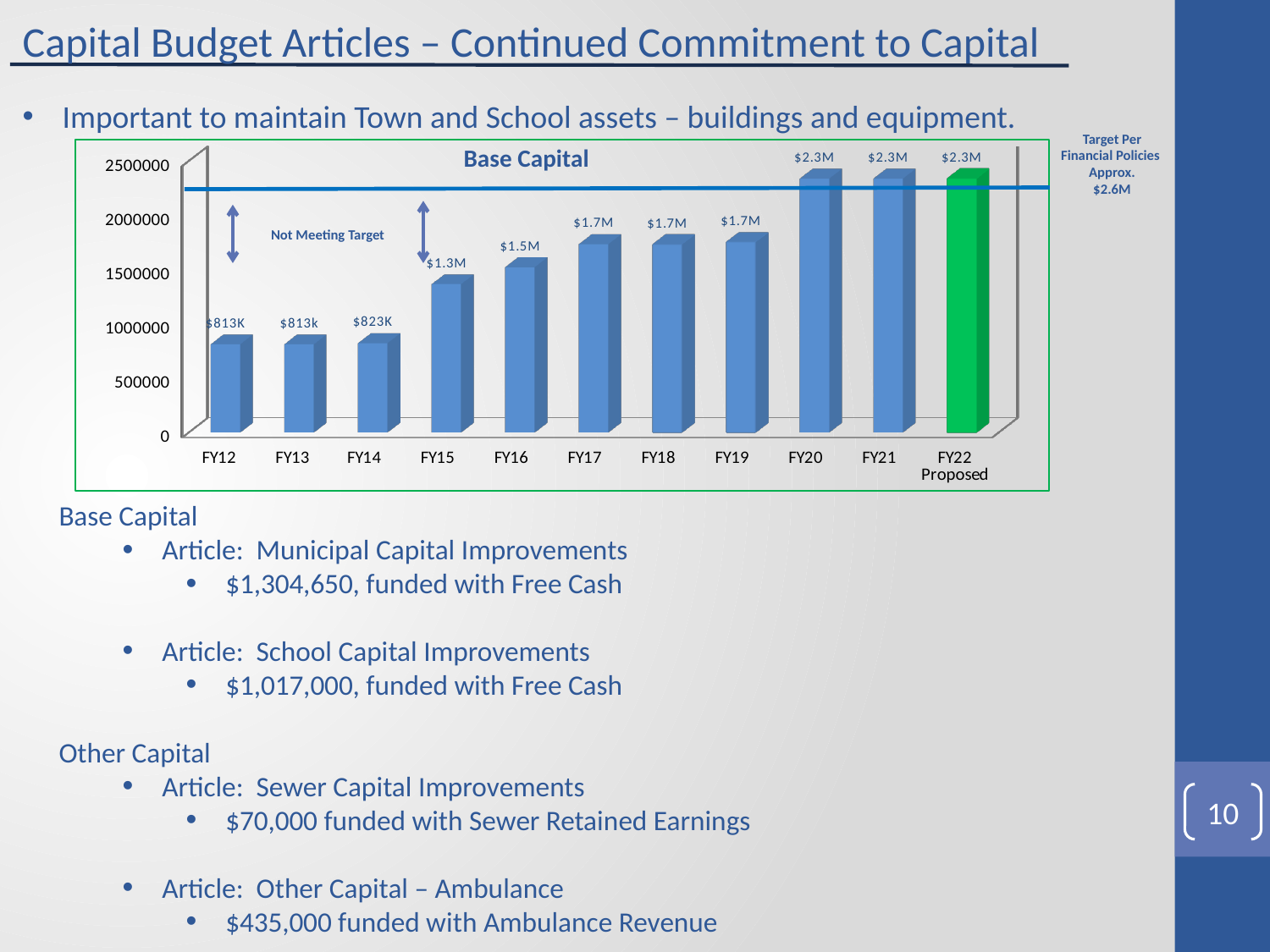
What colour is the FY22 Proposed bar in the Base Capital chart? Green Do the values in the Base Capital chart generally rise or fall from FY12 to FY22 Proposed? Rise What is the value for FY12 in the Base Capital chart? $813K What is the value for FY14 in the Base Capital chart? $823K What is the difference between the FY20 value and the FY19 value in the Base Capital chart? $0.6M How many fiscal years are shown on the x axis of the Base Capital chart? 11 What is the value for FY16 in the Base Capital chart? $1.5M Is the value for FY15 in the Base Capital chart greater or less than 1000000? greater What kind of chart is the Base Capital chart? Bar chart What is the value for FY22 Proposed in the Base Capital chart? $2.3M Is the value for FY20 in the Base Capital chart greater or less than 2000000? greater Which is larger in the Base Capital chart, the value for FY15 or the value for FY17? FY17